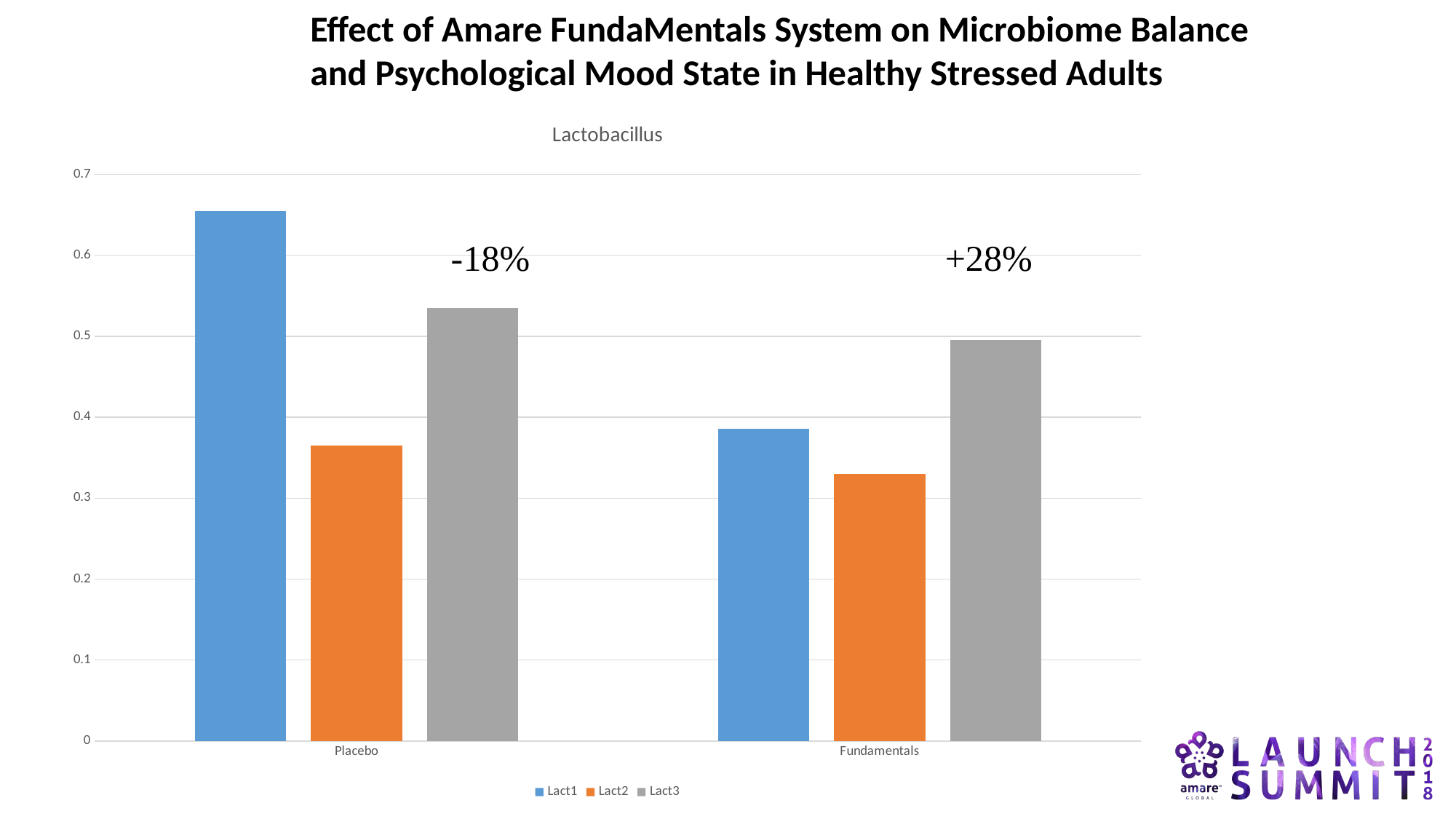
How many series does the legend list? 3 What is the title shown directly above the chart's plot area? Lactobacillus Is the Lact3 value for Placebo greater or less than 0.5? greater Which bar is the highest in the chart? Lact1 for Placebo Which bar is the lowest in the chart? Lact2 for Fundamentals What percentage change is annotated above the Fundamentals group? +28% How many categories are shown on the x axis? 2 What kind of chart is shown on the slide? bar chart Is the Lact2 value for Placebo greater or less than 0.4? less Which is larger, the Lact1 value for Placebo or the Lact1 value for Fundamentals? Placebo Is the Lact1 value for Placebo greater or less than 0.6? greater